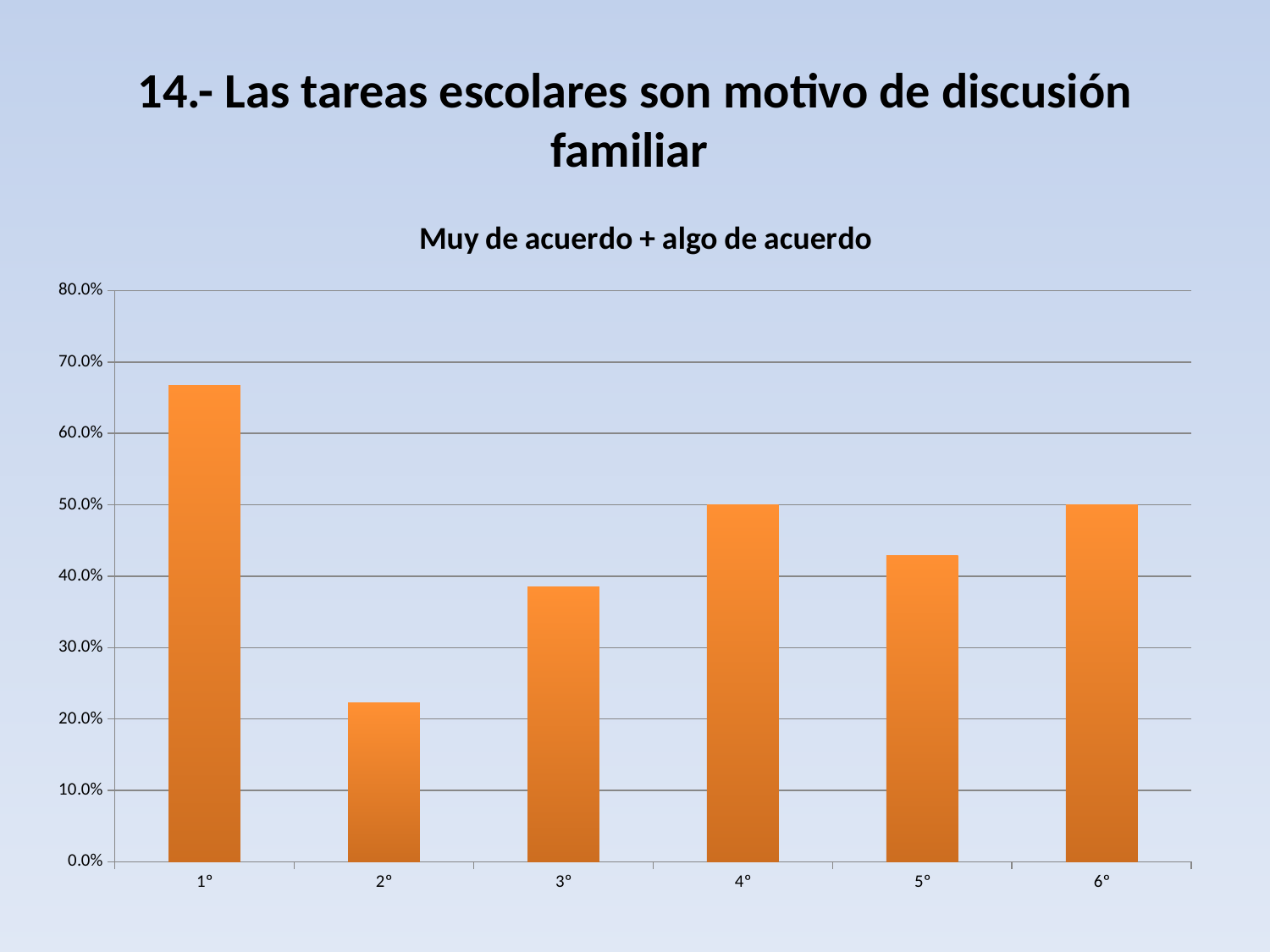
How many categories are plotted on the x axis? 6 Which category has the lowest value? 2° Is the value for 3° greater or less than 40.0%? less Which category has the highest value? 1° Which is larger, the value for 2° or the value for 3°? 3° What is the title of the chart? Muy de acuerdo + algo de acuerdo Is the value for 5° greater or less than 40.0%? greater What kind of chart is shown on the slide? Bar chart Is the value for 1° greater or less than 60.0%? greater Which is larger, the value for 3° or the value for 5°? 5° What colour are the bars in the chart? Orange